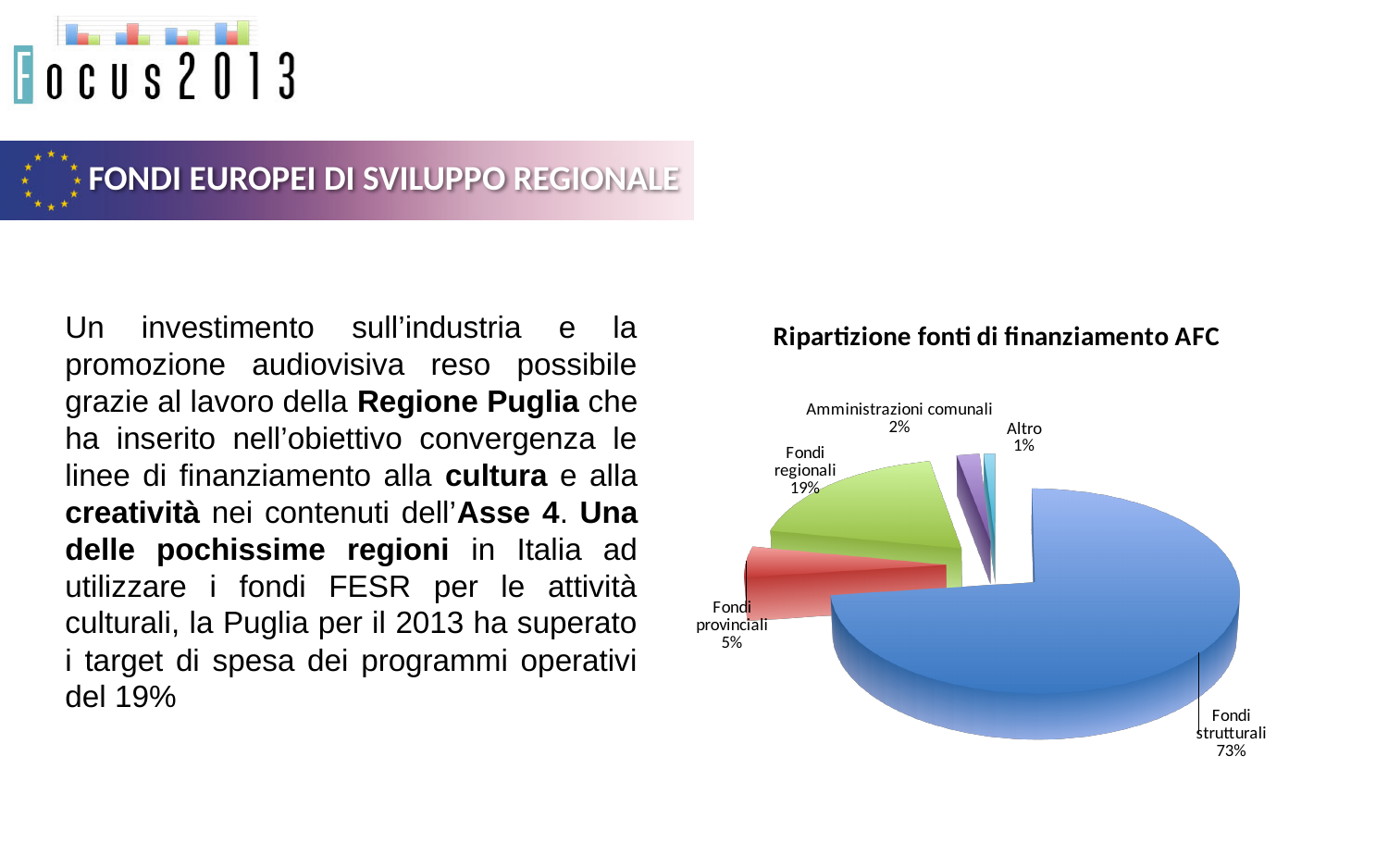
Which category has the smallest share of the pie? Altro What share of the pie is Amministrazioni comunali? 2% What type of chart is shown on the slide? Pie chart What is the difference in percentage points between Fondi strutturali and Fondi regionali? 54 percentage points Which category has the largest share of the pie? Fondi strutturali What share of the pie is Fondi regionali? 19% What is the title of the chart? Ripartizione fonti di finanziamento AFC What share of the pie is Fondi provinciali? 5% How many slices does the pie chart have? 5 Which is larger, the share for Fondi provinciali or the share for Amministrazioni comunali? Fondi provinciali